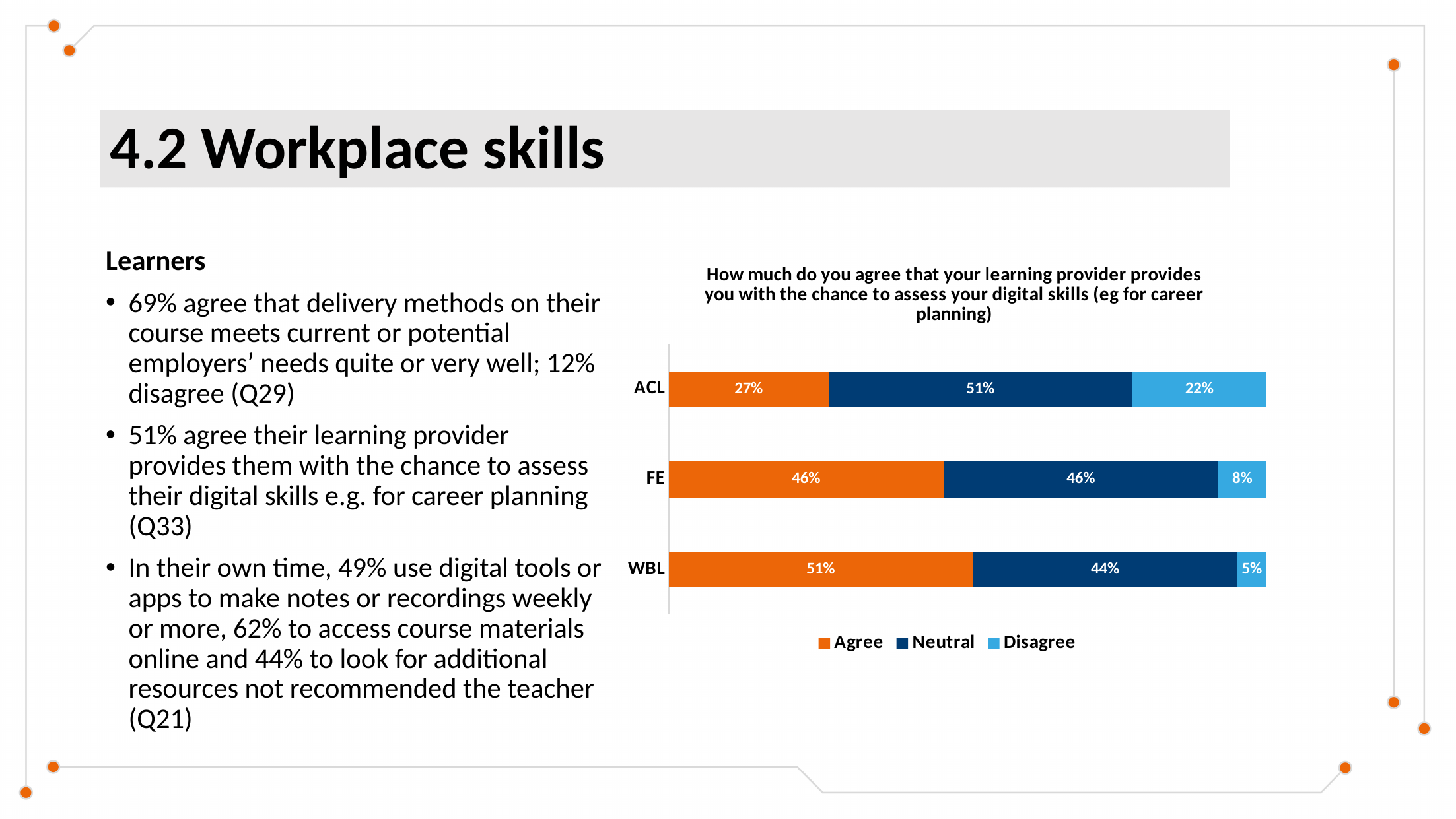
What is the Neutral value for FE in the chart? 46% What percentage of ACL learners agree that their learning provider gives them the chance to assess their digital skills? 27% What is the Disagree value for WBL in the chart? 5% How many series does the legend list? 3 Which series is shown in orange in the chart? Agree Which category has the lowest Disagree percentage? WBL What is the difference between the Disagree values for ACL and FE? 14% Which category has the highest Agree percentage? WBL What is the total of the stacked bar for ACL? 100% How many categories are shown on the chart? 3 Which is larger: the Neutral value for ACL or the Neutral value for WBL? ACL What kind of chart is shown on the slide? Stacked bar chart